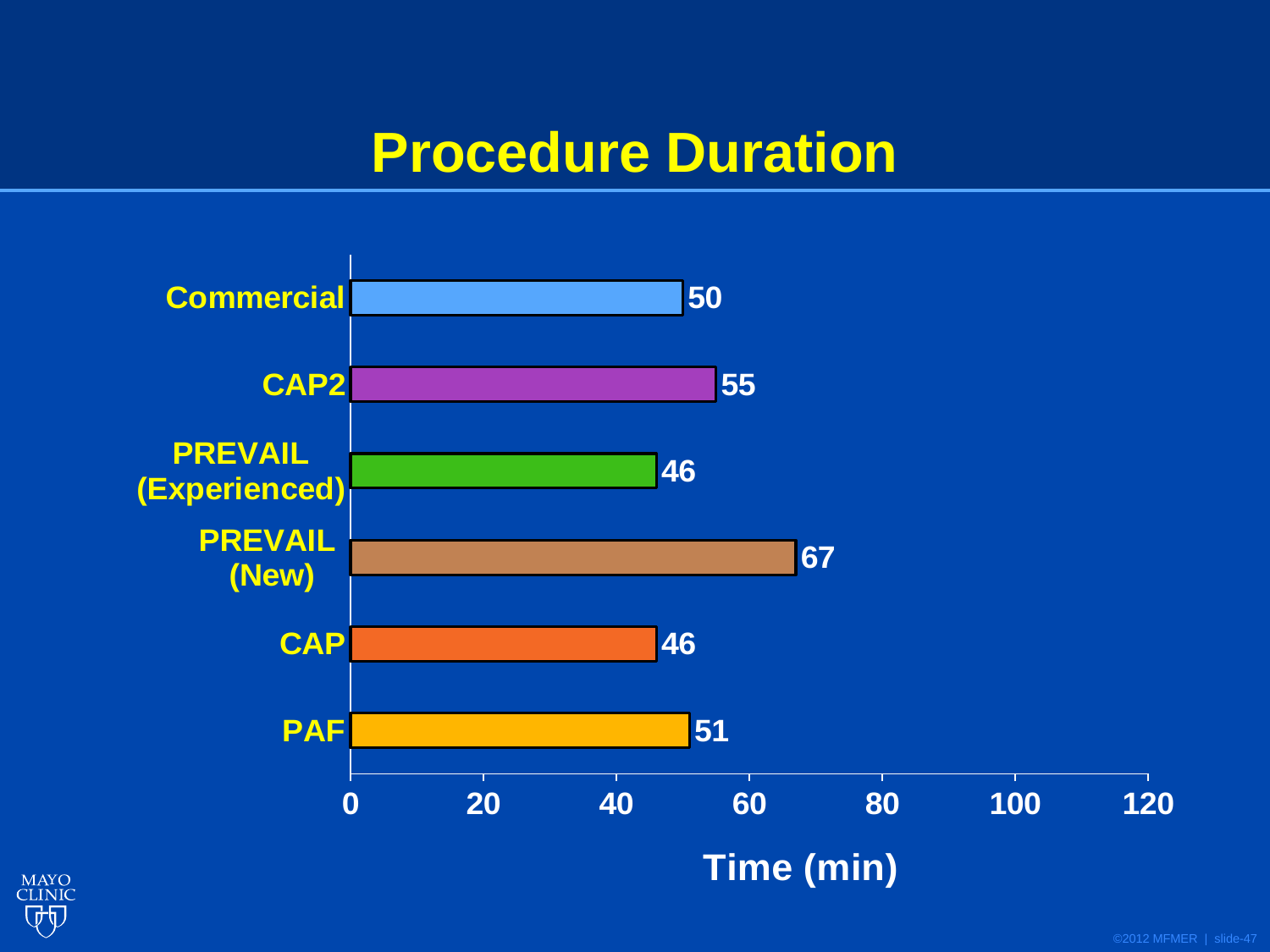
How many categories are shown in the chart? 6 What is the procedure duration for CAP2? 55 What is the procedure duration for PREVAIL (New)? 67 What is the label of the horizontal axis? Time (min) What is the difference in procedure duration between PREVAIL (New) and PREVAIL (Experienced)? 21 Which category has the longest procedure duration? PREVAIL (New) What is the procedure duration for Commercial? 50 What is the difference in procedure duration between CAP2 and Commercial? 5 What is the title of the chart? Procedure Duration Is the value for PREVAIL (New) greater or less than 60? greater What kind of chart is shown on the slide? bar chart Which has a longer procedure duration, PAF or CAP? PAF